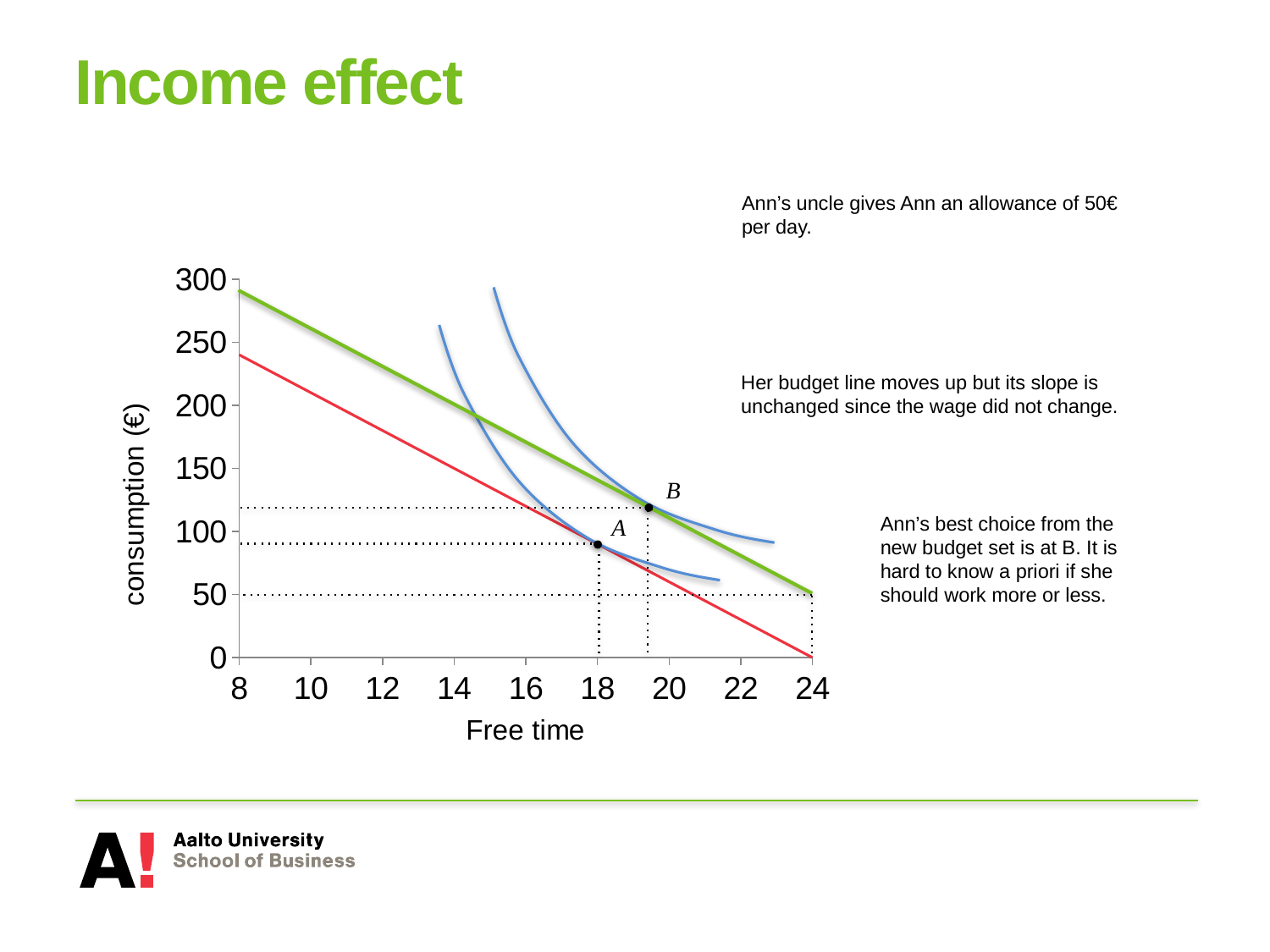
What is the free time value at point A? 18 What consumption value does the red budget line reach at 24 hours of free time? 0 What consumption value does the green budget line reach at 24 hours of free time? 50 What kind of chart is shown on the slide? line chart Is the consumption value at point B greater or less than 100? greater What is the title of the slide containing the chart? Income effect Is the consumption value at point A greater or less than 100? less Which point has the higher consumption, A or B? B Do the budget lines rise or fall as free time increases along the x axis? fall Is the free time value at point B greater or less than 18? greater How many labelled points (A, B) are marked on the chart? 2 What is the label of the y axis? consumption (€)